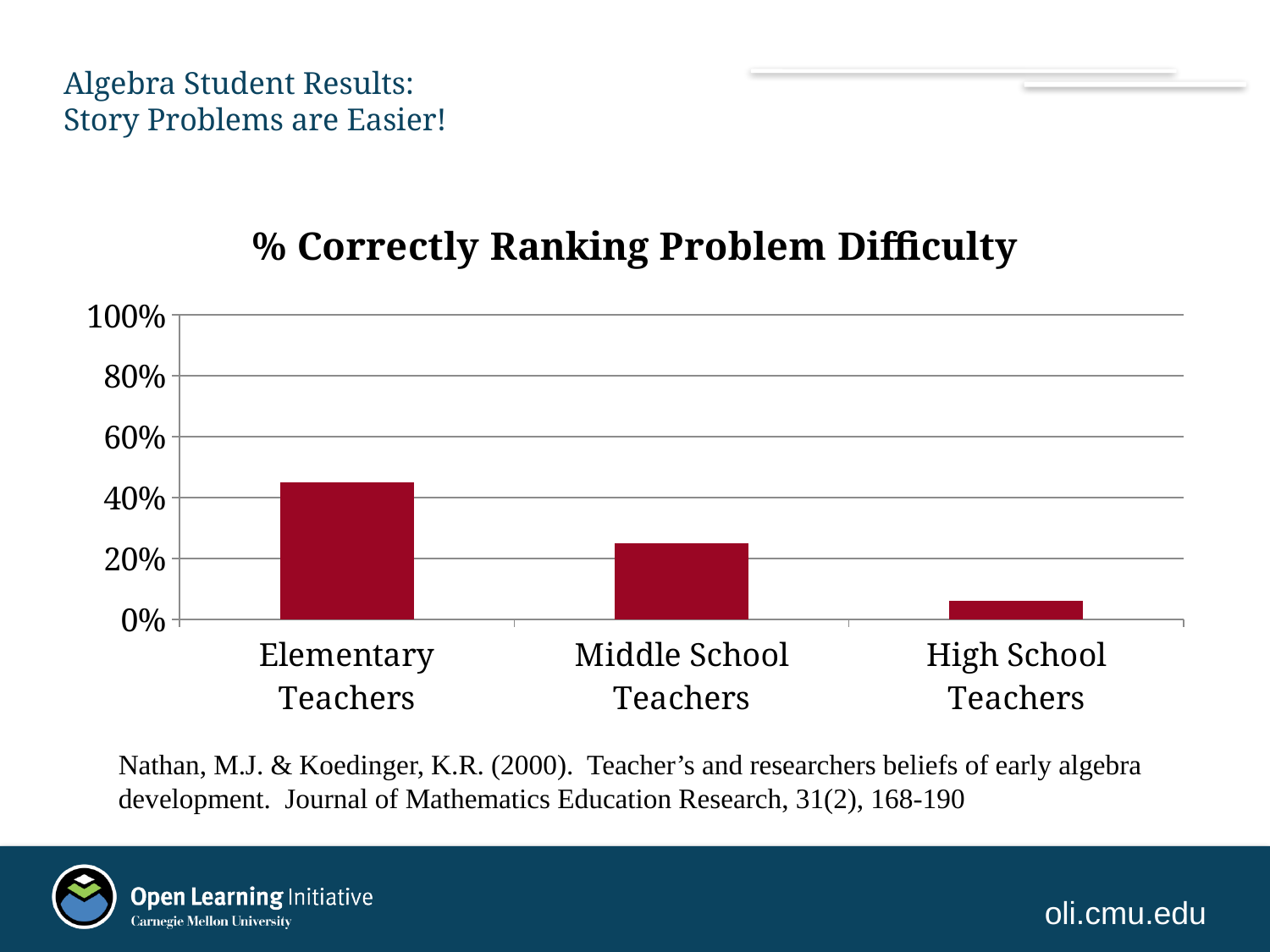
Is the value for Middle School Teachers greater or less than 40%? less Which category has the lowest value in the chart? High School Teachers Is the value for High School Teachers greater or less than 20%? less Which is larger, the value for Middle School Teachers or the value for High School Teachers? Middle School Teachers Is the value for Elementary Teachers greater or less than 60%? less Do the values rise or fall moving from Elementary Teachers to High School Teachers along the x axis? fall Which is larger, the value for Elementary Teachers or the value for Middle School Teachers? Elementary Teachers How many categories are shown on the x axis of the chart? 3 What is the title of the chart? % Correctly Ranking Problem Difficulty Which category has the highest value in the chart? Elementary Teachers What kind of chart is shown on the slide? Bar chart